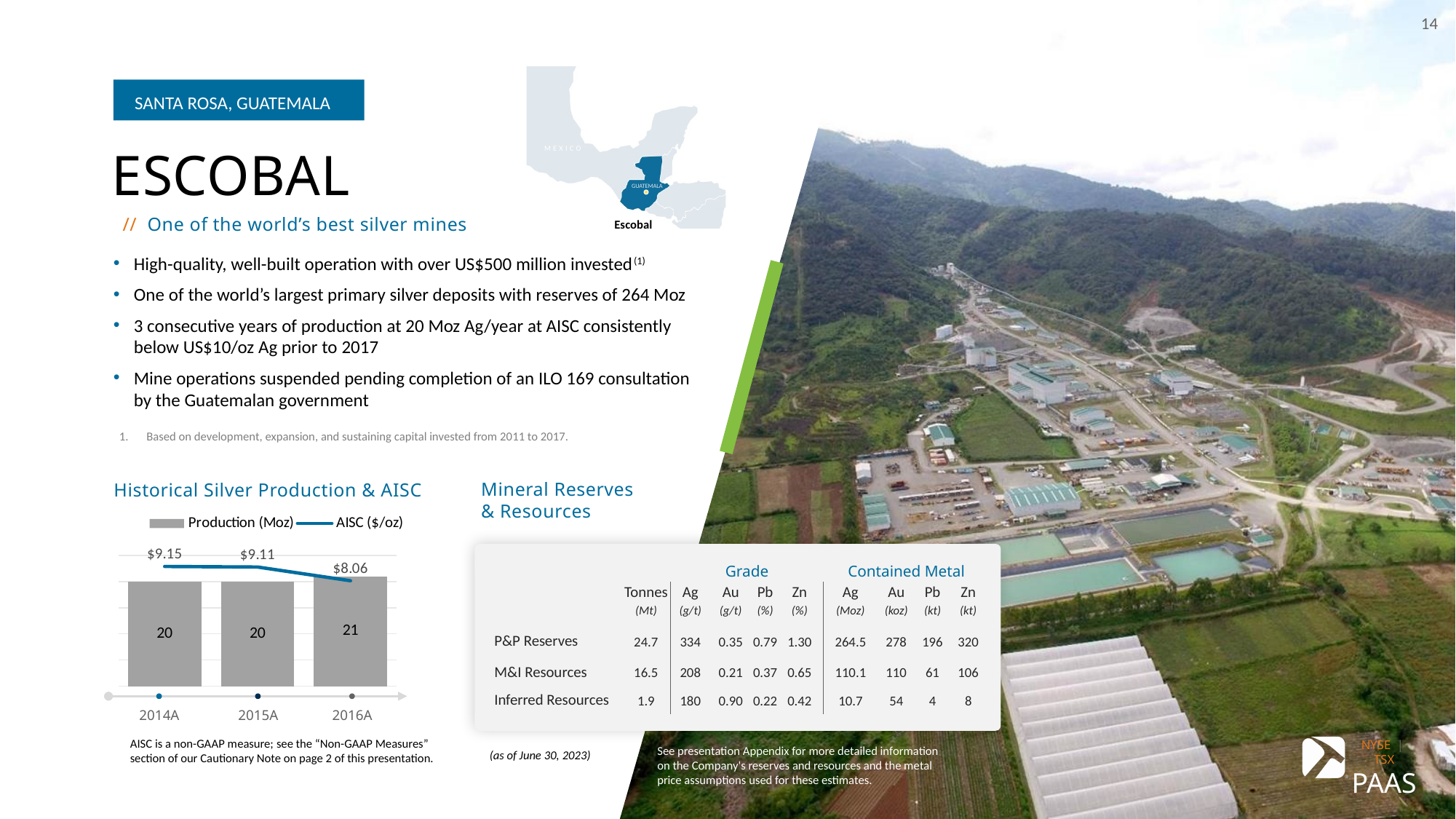
What is the difference between the AISC for 2014A and 2016A in the Historical Silver Production & AISC chart? $1.09 Does the AISC line rise or fall from 2014A to 2016A in the Historical Silver Production & AISC chart? fall What are the two legend entries in the Historical Silver Production & AISC chart? Production (Moz) and AISC ($/oz) What is the AISC value shown for 2016A in the Historical Silver Production & AISC chart? $8.06 How many years are shown on the x axis of the Historical Silver Production & AISC chart? 3 Is the AISC for 2015A higher or lower than the AISC for 2016A in the Historical Silver Production & AISC chart? higher Which year has the highest production in the Historical Silver Production & AISC chart? 2016A What is the production value shown for 2016A in the Historical Silver Production & AISC chart? 21 Which year has the lowest AISC in the Historical Silver Production & AISC chart? 2016A What is the AISC value shown for 2014A in the Historical Silver Production & AISC chart? $9.15 What is the production value shown for 2015A in the Historical Silver Production & AISC chart? 20 How many series does the legend of the Historical Silver Production & AISC chart list? 2